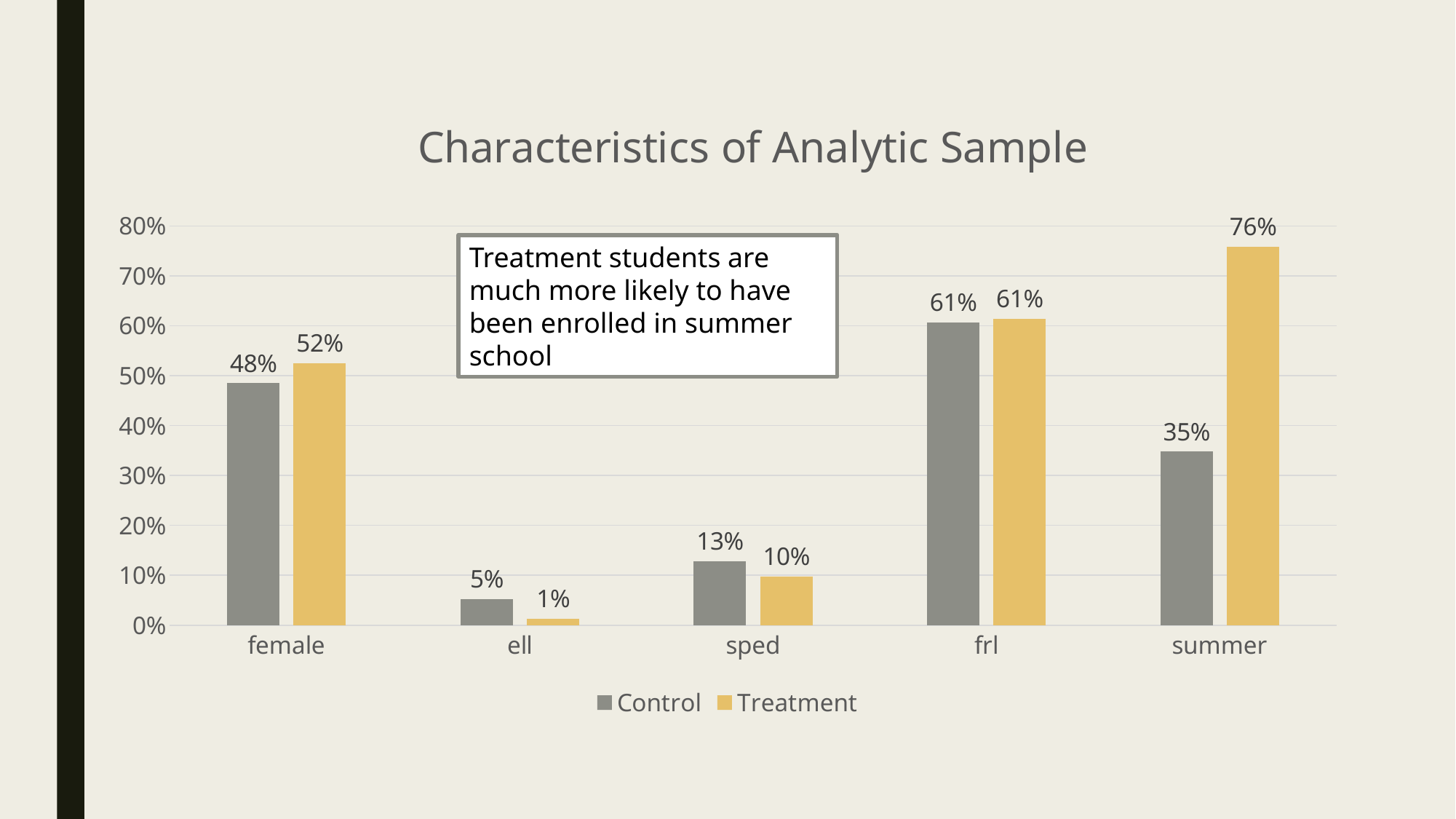
What is the Control value for sped? 13% How many series does the legend list? 2 What kind of chart is this? bar chart What is the difference between the Treatment and Control values for summer? 41% What is the Control value for summer? 35% Which is larger for sped, the Control value or the Treatment value? Control Which category has the lowest Control value? ell What is the Treatment value for ell? 1% How many categories are shown on the x axis? 5 What is the title of the chart? Characteristics of Analytic Sample What is the Treatment value for summer? 76% Which category has the highest Treatment value? summer